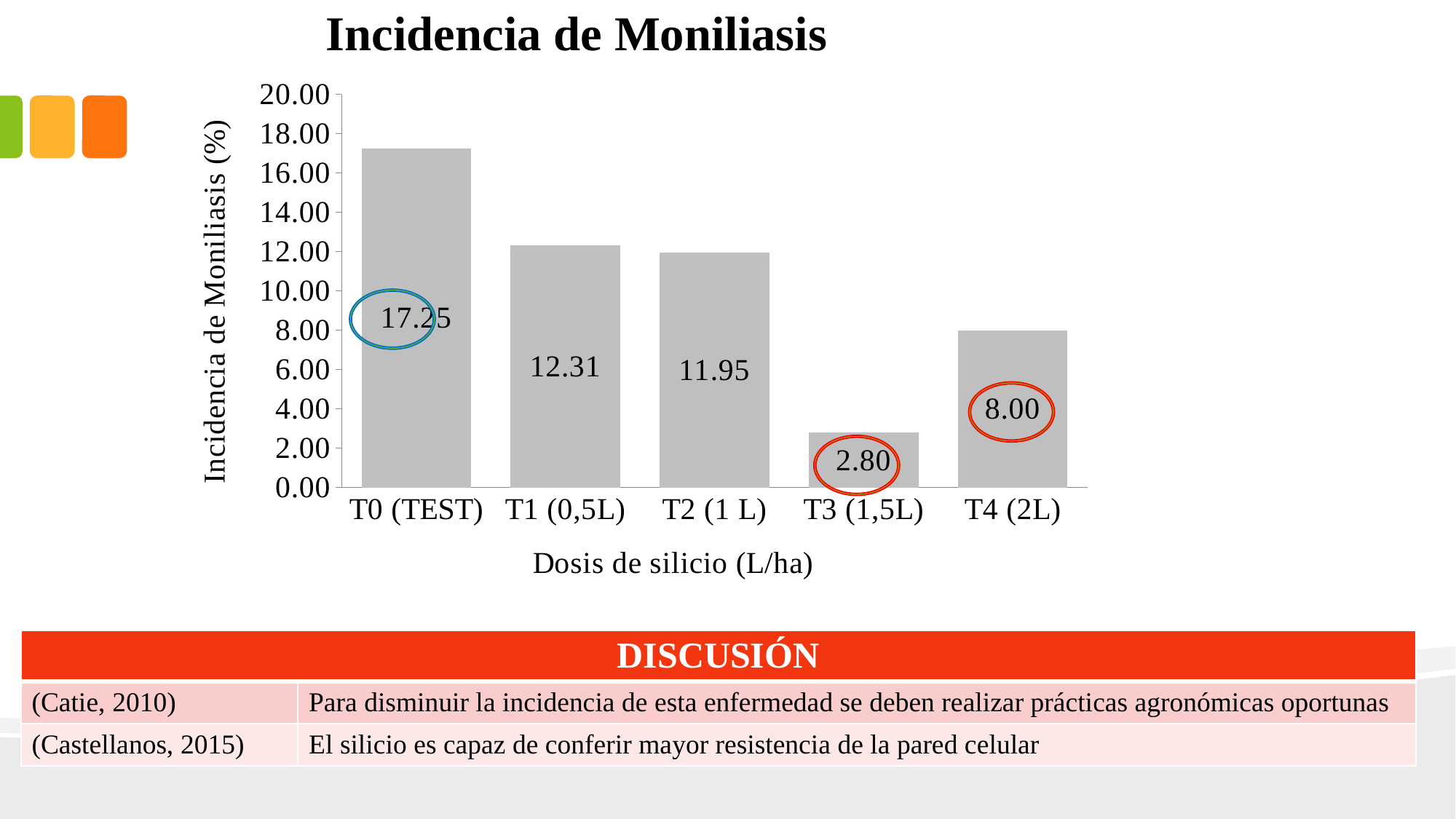
What is the title of the chart? Incidencia de Moniliasis What is the incidence of Moniliasis for T4 (2L)? 8.00 What kind of chart is shown on the slide? Bar chart How many treatments (bars) are shown in the chart? 5 What is the incidence of Moniliasis for T1 (0,5L)? 12.31 Which treatment has the highest incidence of Moniliasis? T0 (TEST) What is the incidence of Moniliasis for T0 (TEST)? 17.25 What is the difference in incidence between T1 (0,5L) and T2 (1 L)? 0.36 Which treatment has the lowest incidence of Moniliasis? T3 (1,5L) What is the difference in incidence between T0 (TEST) and T3 (1,5L)? 14.45 What is the incidence of Moniliasis for T3 (1,5L)? 2.80 Which has a higher incidence of Moniliasis, T2 (1 L) or T4 (2L)? T2 (1 L)